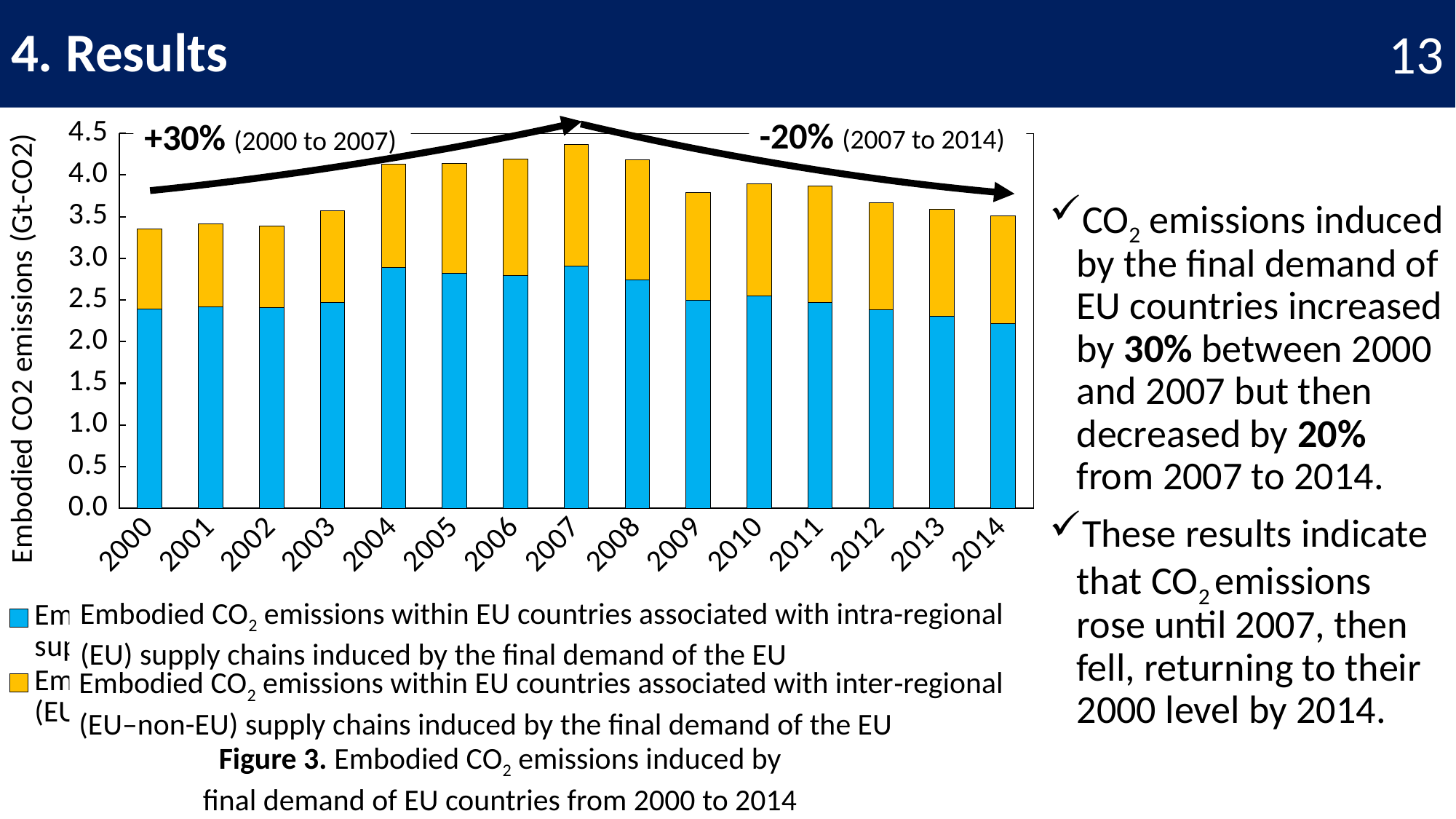
Is the total embodied CO2 emissions for 2000 greater or less than 3.5 Gt-CO2? less Is the total embodied CO2 emissions for 2009 greater or less than 4.0 Gt-CO2? less Which year has the highest total embodied CO2 emissions in the chart? 2007 According to the annotation on the chart, by what percentage did emissions change from 2000 to 2007? +30% What is the label of the chart's y axis? Embodied CO2 emissions (Gt-CO2) Is the total embodied CO2 emissions for 2007 larger or smaller than that for 2014? larger Is the total embodied CO2 emissions for 2007 greater or less than 4.0 Gt-CO2? greater Do total embodied CO2 emissions rise or fall from 2007 to 2014? fall How many series does the chart's legend list? 2 What kind of chart is shown on the slide? Stacked bar chart How many years are plotted along the x axis of the chart? 15